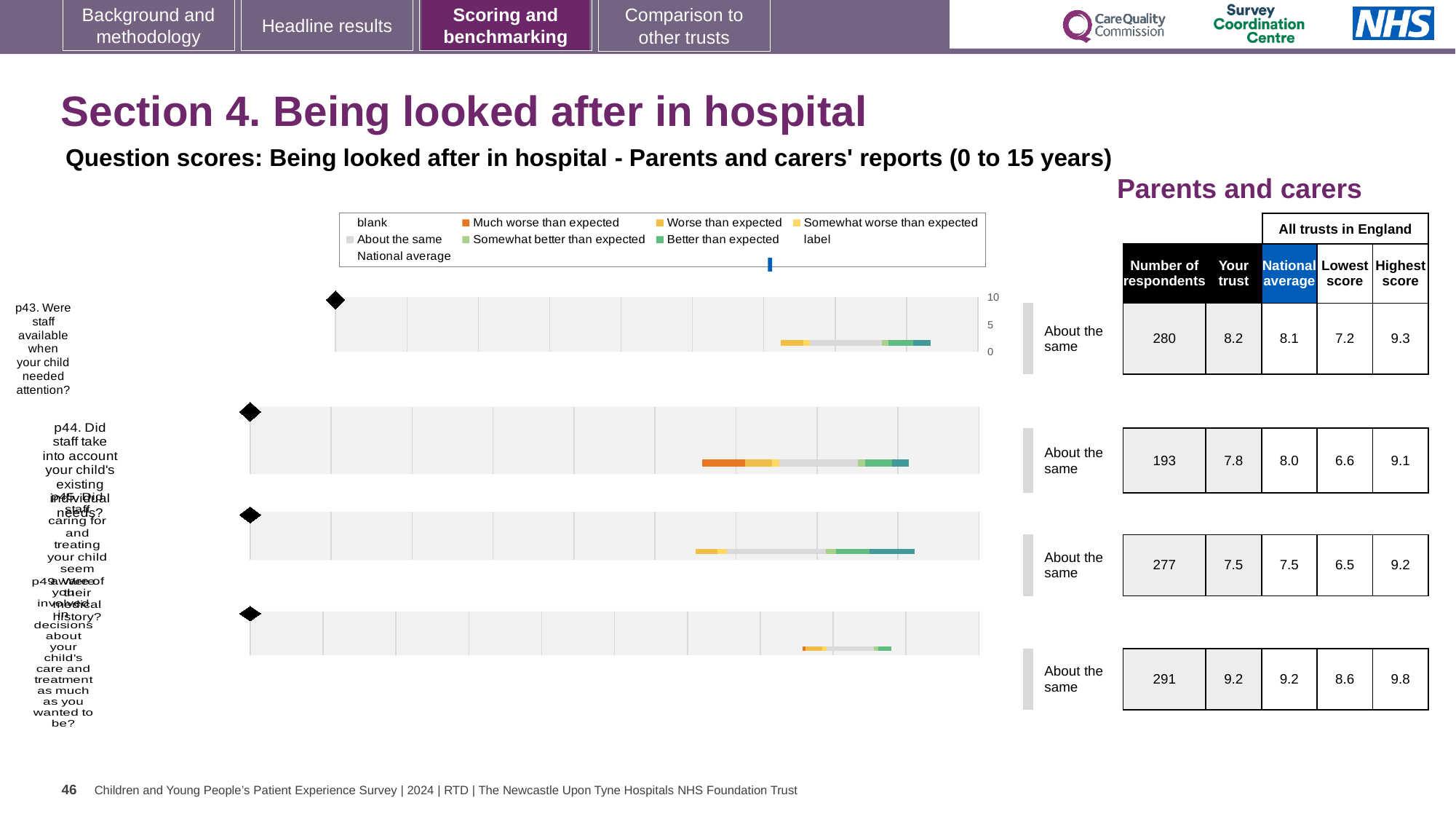
How many respondents are listed for p44 (Did staff take into account your child's existing individual needs?)? 193 What is the 'Your trust' score for p43 (Were staff available when your child needed attention?)? 8.2 What kind of chart is used for each question on the slide? Bar chart What is the national average score for p45? 7.5 What is the highest score across all trusts in England for p49? 9.8 For p44, which is larger: the 'Your trust' score or the national average? National average What benchmark category is shown next to the chart for p45? About the same What is the difference between the highest score and the lowest score for p49? 1.2 What is the difference between the 'Your trust' score and the national average for p43? 0.1 Which question has the highest 'Your trust' score? p49 How many question charts are shown on the slide? 4 Which question has the lowest 'Your trust' score? p45